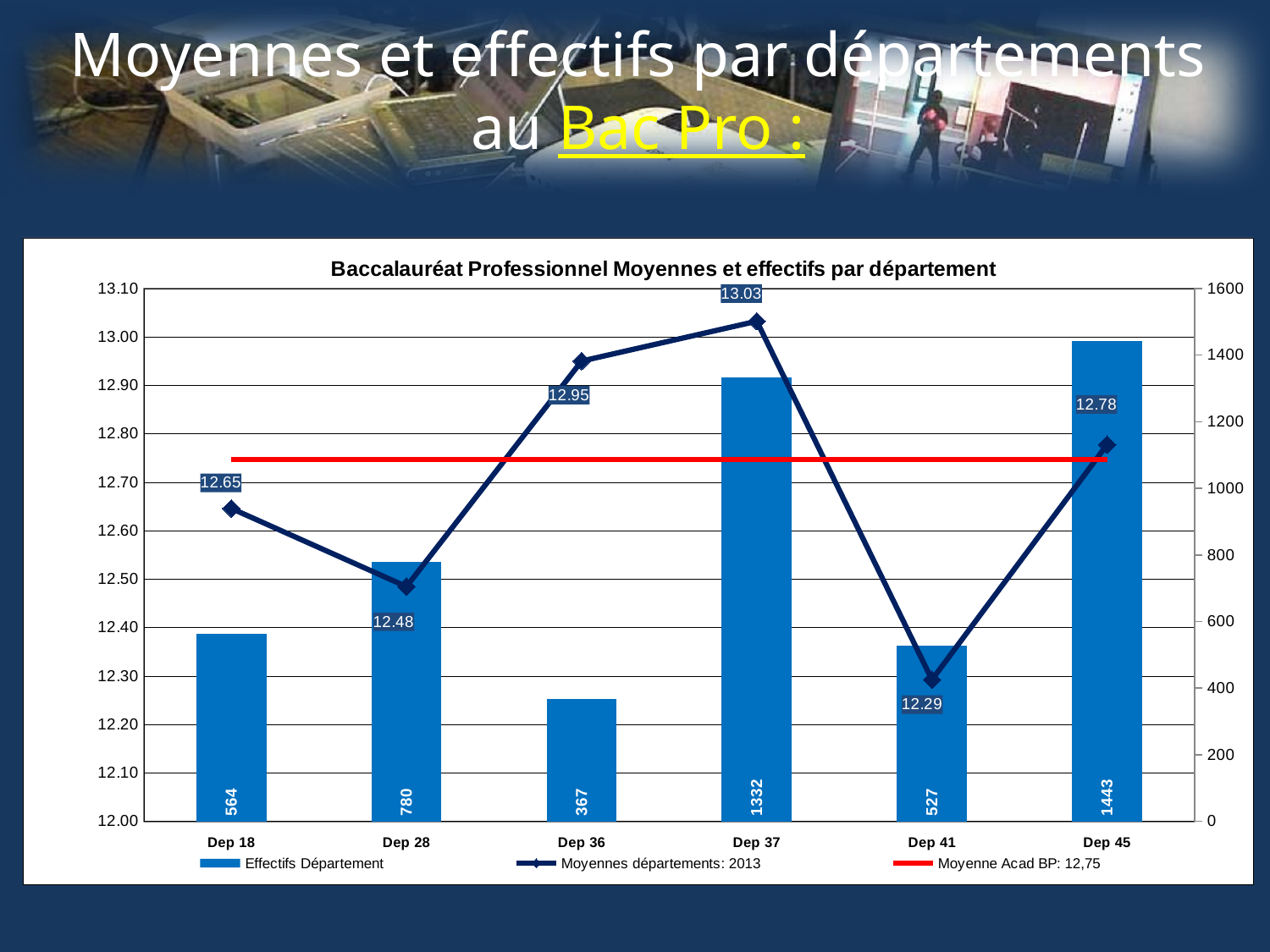
Which department has the highest Effectifs Département? Dep 45 What is the value of Effectifs Département for Dep 37? 1332 What is the difference in Effectifs Département between Dep 45 and Dep 36? 1076 What is the title of the chart? Baccalauréat Professionnel Moyennes et effectifs par département Which department has the lowest Moyennes départements: 2013 value? Dep 41 What is the value of the Moyenne Acad BP line shown in the legend? 12,75 What is the Moyennes départements: 2013 value for Dep 41? 12.29 Is the Effectifs Département value for Dep 28 greater or less than 600? greater How many series does the legend list? 3 What kind of chart is used to show Effectifs Département? bar chart Which is larger, the Moyennes départements: 2013 value for Dep 18 or for Dep 28? Dep 18 How many departments are shown on the x axis? 6